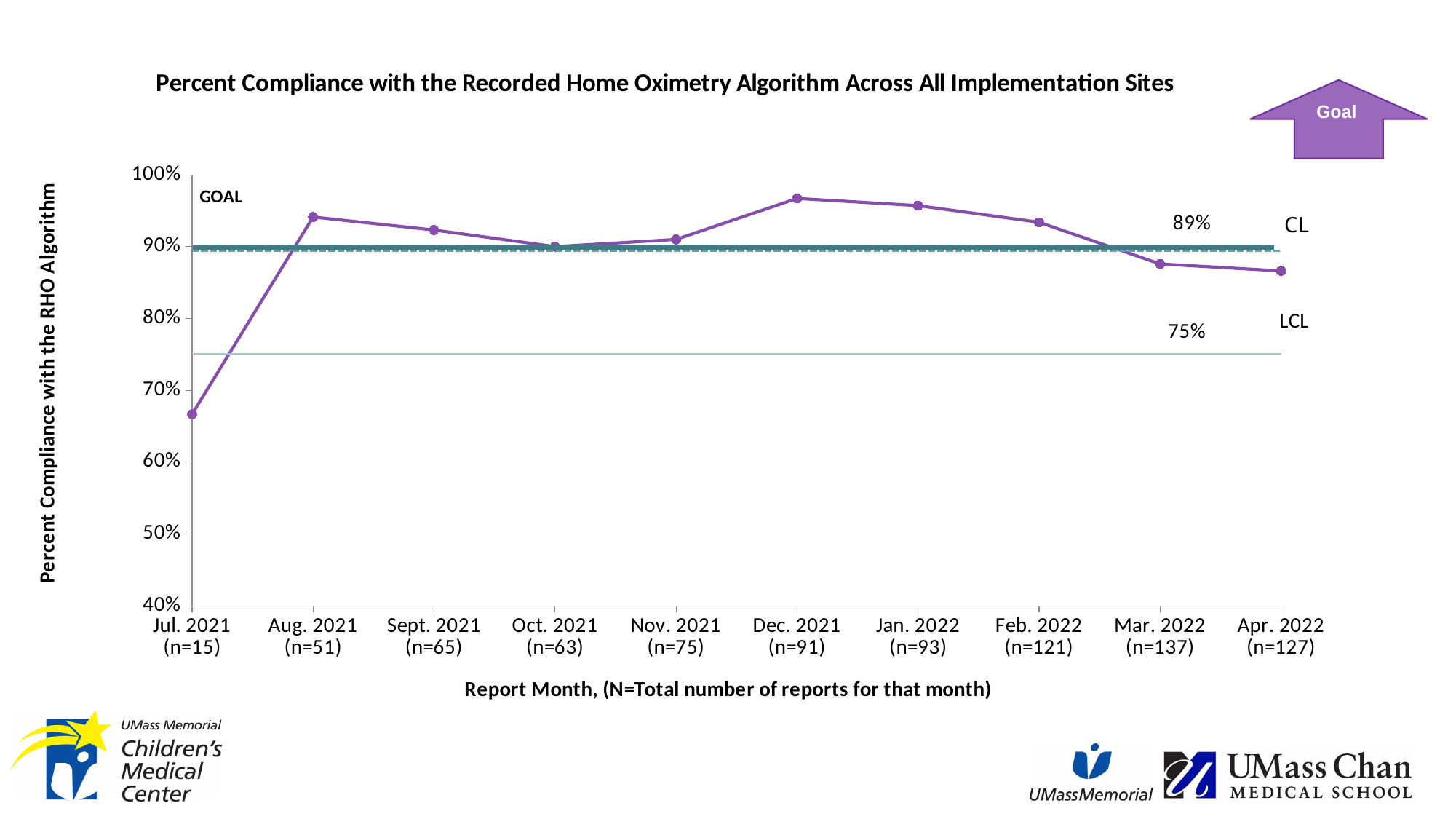
Which is higher, the value for Aug. 2021 or the value for Mar. 2022? Aug. 2021 What value is labelled for the CL line? 89% What is the title of the chart? Percent Compliance with the Recorded Home Oximetry Algorithm Across All Implementation Sites Which report month has the highest percent compliance? Dec. 2021 What value is labelled for the LCL line? 75% Do the values rise or fall from Dec. 2021 to Apr. 2022? fall What kind of chart is shown on the slide? line chart Is the value for Jul. 2021 greater or less than 70%? less Is the value for Dec. 2021 greater or less than 90%? greater Which report month has the lowest percent compliance? Jul. 2021 What is the difference between the CL value and the LCL value? 14 percentage points How many report months are plotted on the x axis? 10